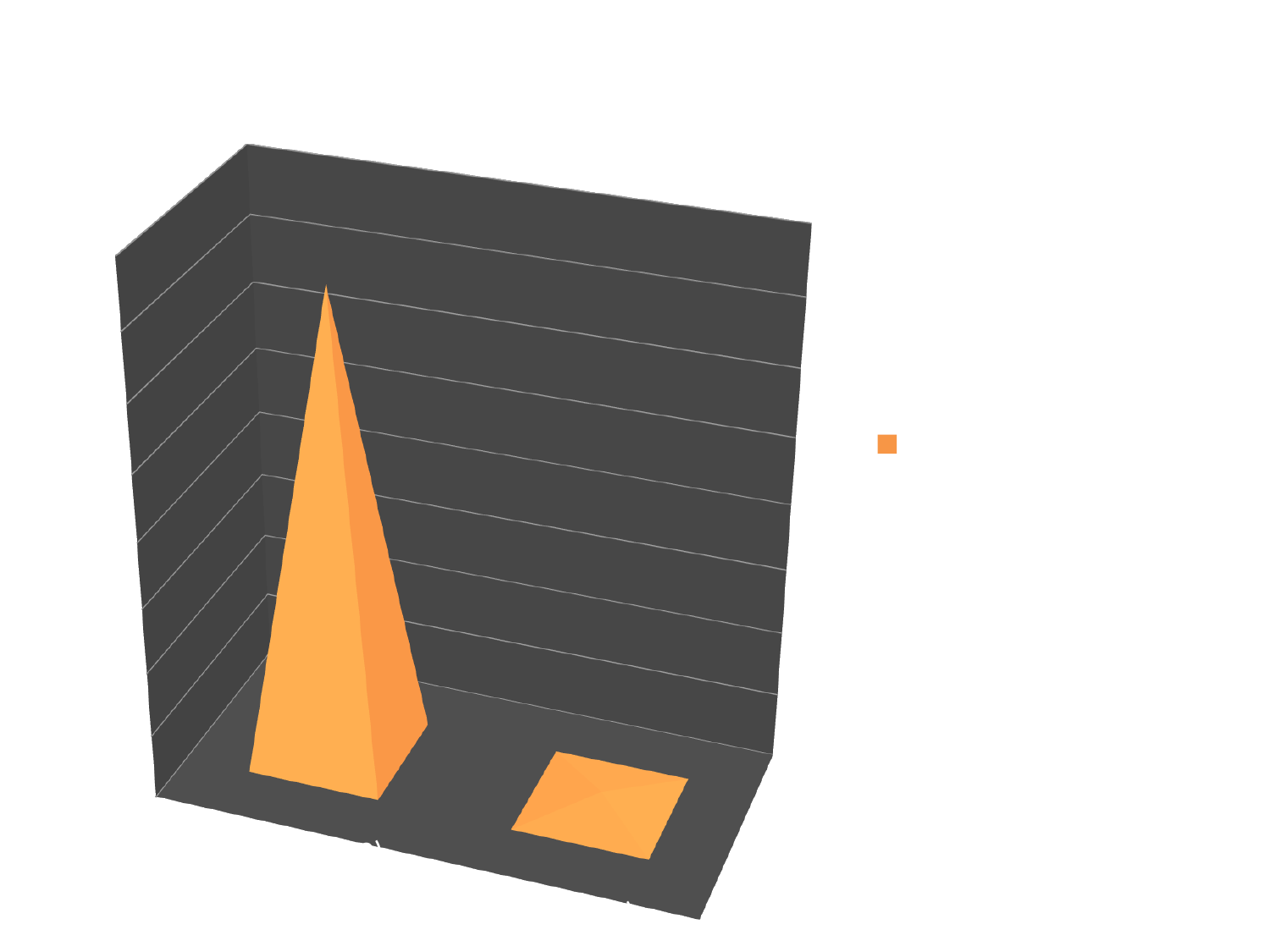
Do the values rise or fall from the left bar to the right bar? fall How many series does the legend list? 1 Which bar is taller, the left one or the right one? the left one What colour are the bars in the chart? orange How many bars are plotted in the chart? 2 What kind of chart is shown on the slide? bar chart